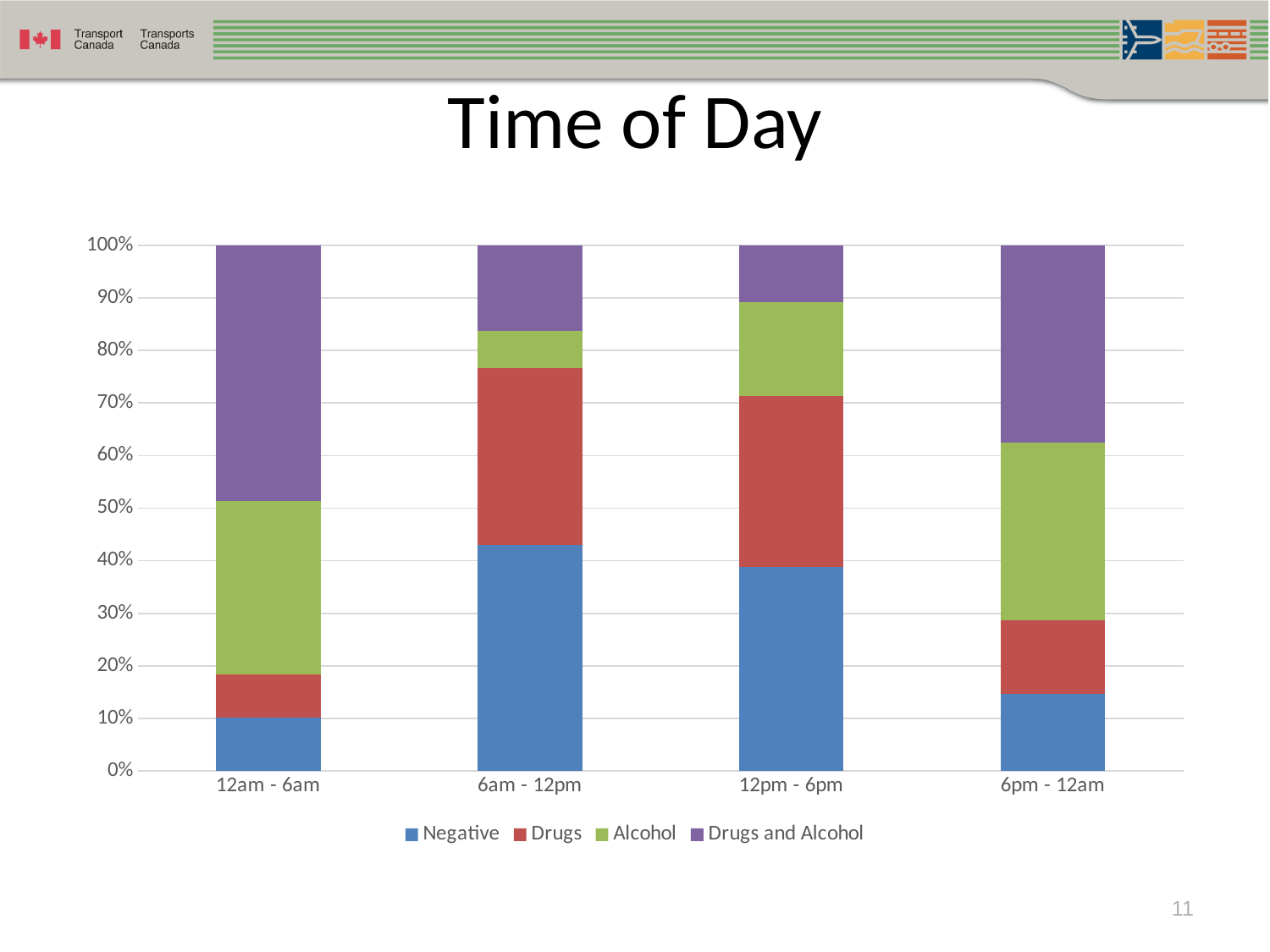
Is the Negative share for 6am - 12pm greater or less than 40%? greater Which time-of-day category has the largest Negative segment? 6am - 12pm Which time-of-day category has the smallest Drugs and Alcohol segment? 12pm - 6pm What is the title of the chart? Time of Day What is the total height of each stacked bar? 100% Which time-of-day category has the smallest Negative segment? 12am - 6am What kind of chart is shown on the slide? stacked bar chart How many time-of-day categories are shown on the x axis? 4 Which time-of-day category has the largest Drugs and Alcohol segment? 12am - 6am Is the Negative share for 12am - 6am greater or less than 20%? less Is the Alcohol segment larger for 12am - 6am or for 6am - 12pm? 12am - 6am How many series does the legend list? 4